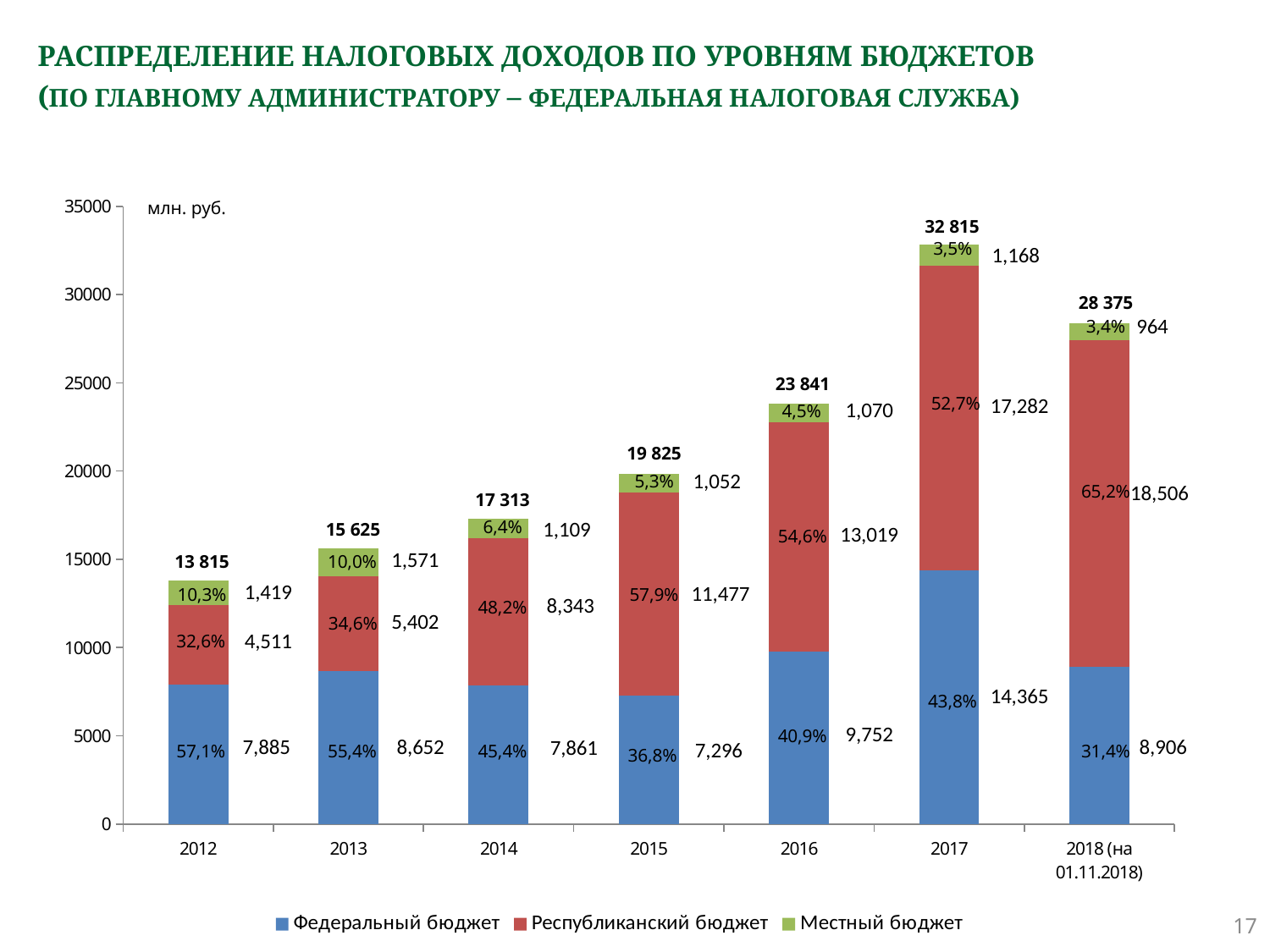
How many years (categories) are shown on the x axis? 7 How many series does the legend list? 3 Do the total values rise or fall from 2012 to 2017? rise What kind of chart is shown on the slide? bar chart What is the value of Федеральный бюджет for 2016? 9,752 What is the value of Местный бюджет for 2018 (на 01.11.2018)? 964 What is the total value printed above the bar for 2017? 32 815 Which is larger: Республиканский бюджет in 2017 or in 2018 (на 01.11.2018)? 2018 (на 01.11.2018) What percentage share is printed for Местный бюджет in 2013? 10,0% Which year has the highest total bar? 2017 Which year has the lowest total bar? 2012 What is the difference between the total for 2017 and the total for 2018 (на 01.11.2018)? 4 440